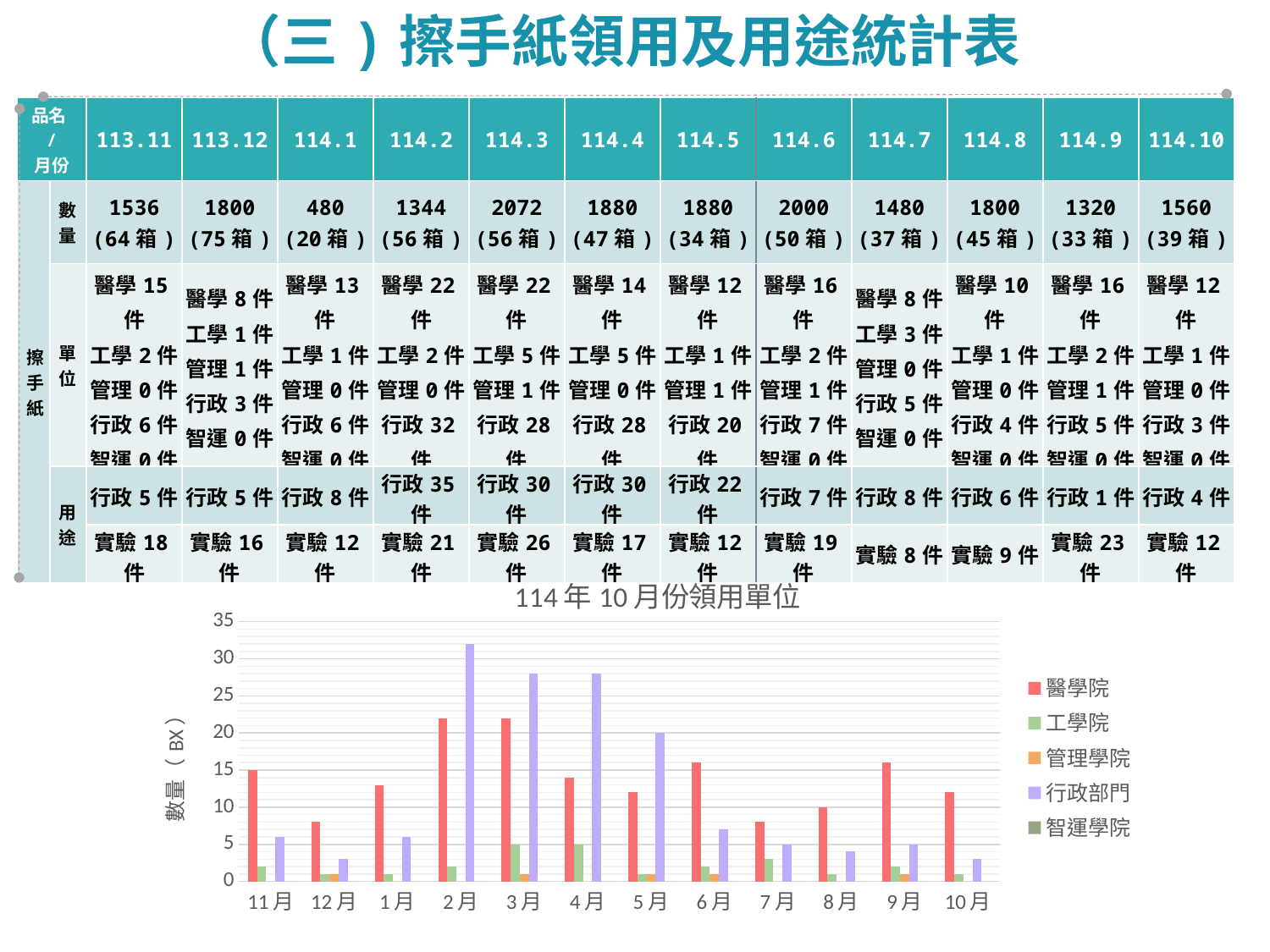
In the bar chart, for 6月, which is larger: the 醫學院 bar or the 行政部門 bar? 醫學院 What kind of chart is shown below the table on the slide? bar chart In the bar chart, which month has the highest 行政部門 bar? 2月 In the bar chart, what is the value of the 醫學院 bar for 11月? 15 In the bar chart, what is the value of the 行政部門 bar for 5月? 20 In the bar chart, is the value of the 行政部門 bar for 4月 greater or less than 25? greater How many series does the legend of the bar chart list? 5 In the bar chart, is the value of the 行政部門 bar for 2月 greater or less than 30? greater In the bar chart, what is the value of the 醫學院 bar for 8月? 10 What is the title of the bar chart? 114年10月份領用單位 How many months are shown on the x axis of the bar chart? 12 In the bar chart, for 3月, which is larger: the 醫學院 bar or the 行政部門 bar? 行政部門